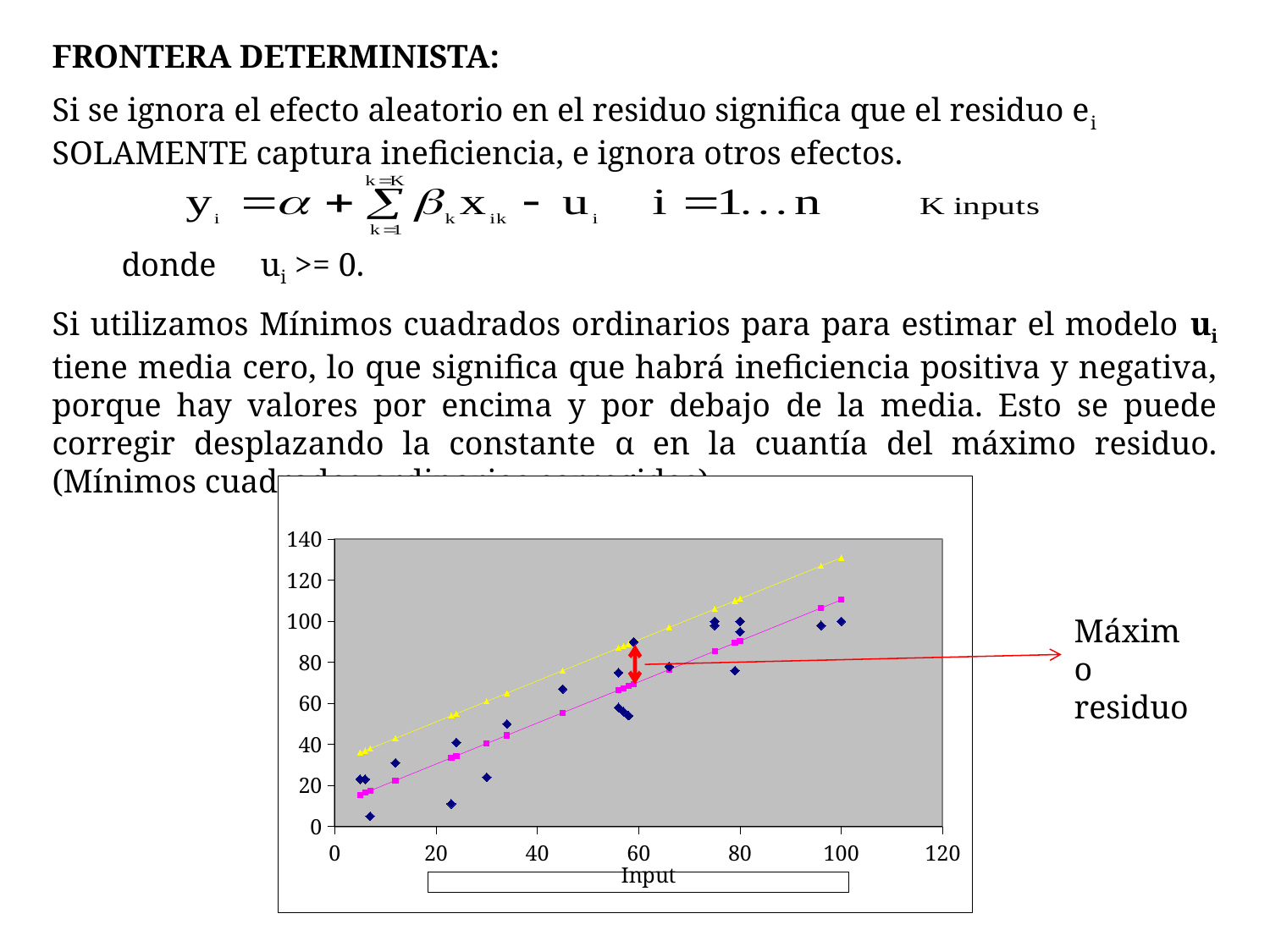
What is the title of the x axis of the chart? Input What kind of chart is shown on the slide? scatter chart Is the lowest blue diamond point greater or less than 20? less Is the yellow triangle value at Input 100 greater or less than 120? greater What is the highest tick value shown on the y axis of the chart? 140 Is the magenta square value at Input 20 greater or less than 40? less How many tick labels are shown on the x axis of the chart? 7 Do the magenta square values rise or fall as Input increases? rise Do the yellow triangle values rise or fall as Input increases? rise At Input 100, which is higher: the yellow triangle line or the magenta square line? yellow triangle line